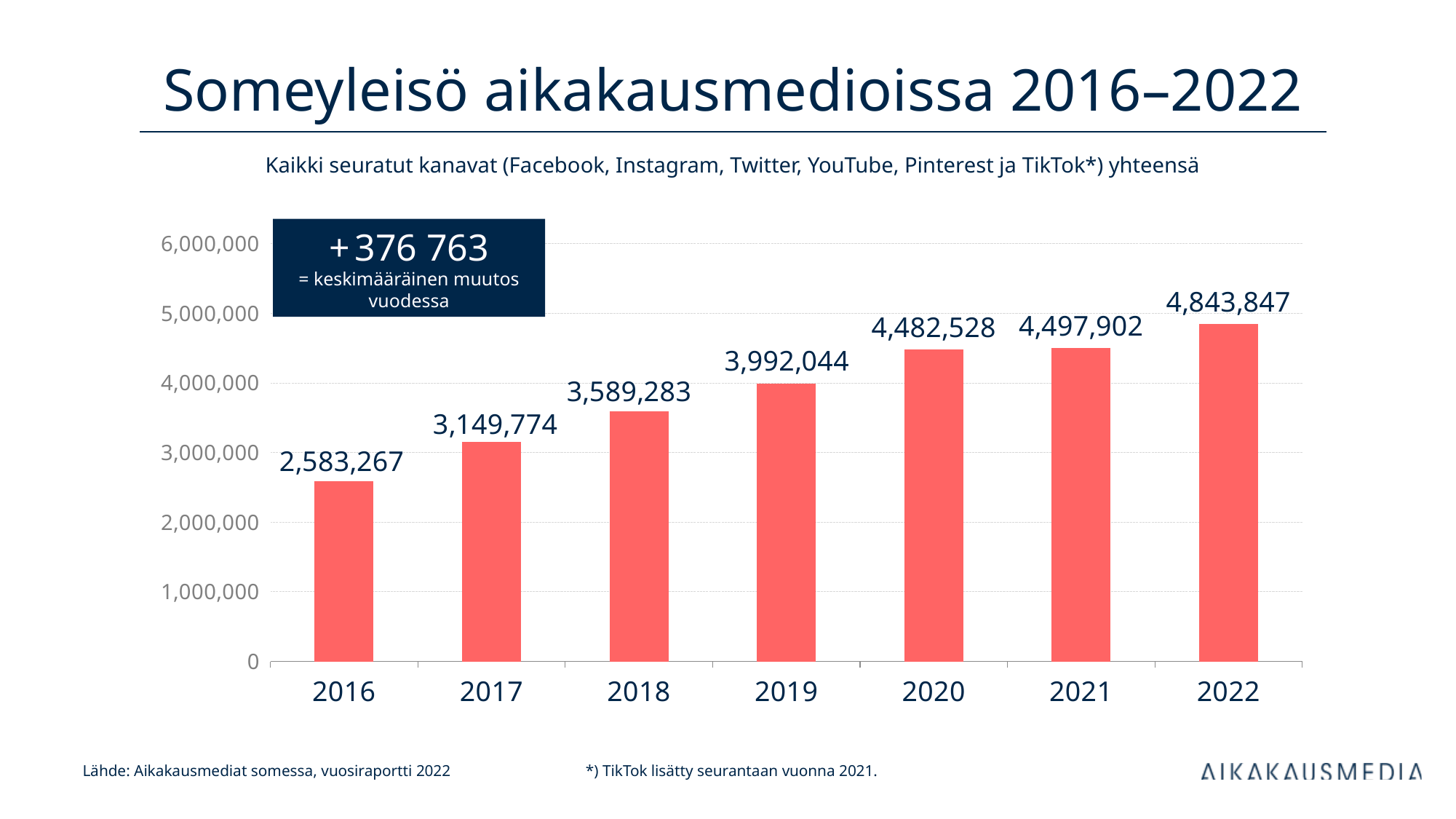
Do the values rise or fall from 2016 to 2022? rise What is the value for 2019? 3,992,044 Which year has the lowest value? 2016 Is the value for 2018 greater or less than 3,000,000? greater What is the difference between the values for 2017 and 2016? 566,507 What is the value for 2022? 4,843,847 Which is larger, the value for 2019 or the value for 2020? 2020 How many years are shown on the x axis? 7 What kind of chart is shown on the slide? bar chart What is the difference between the values for 2022 and 2021? 345,945 Which year has the highest value? 2022 What is the value for 2016? 2,583,267